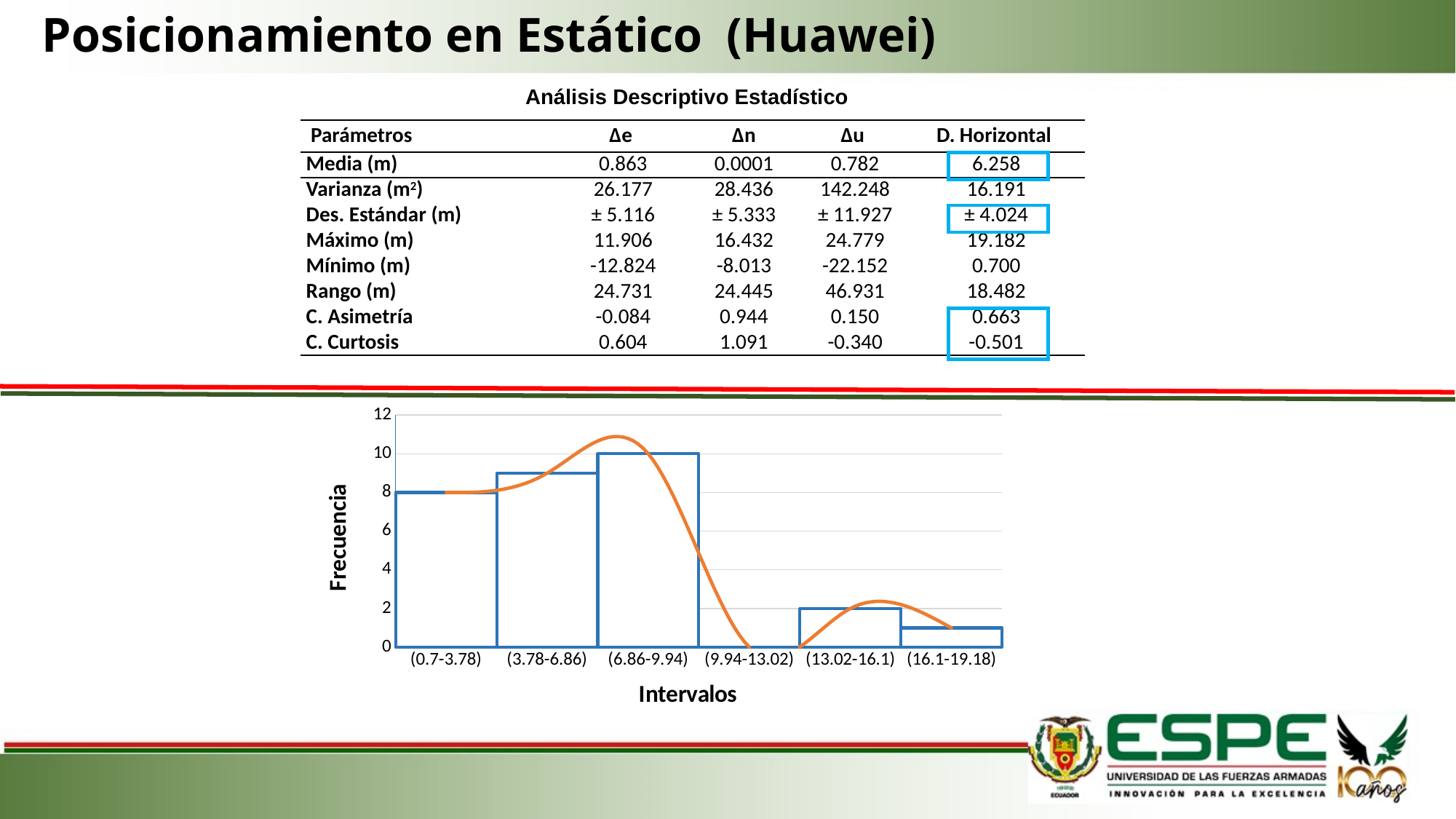
Which interval has the lowest frequency? (9.94-13.02) What is the frequency for the interval (13.02-16.1)? 2 What is the difference in frequency between the intervals (6.86-9.94) and (0.7-3.78)? 2 Is the frequency for the interval (3.78-6.86) greater or less than 8? greater How many intervals are shown on the x axis of the chart? 6 What is the frequency for the interval (9.94-13.02)? 0 What is the frequency for the interval (0.7-3.78)? 8 What is the frequency for the interval (6.86-9.94)? 10 What is the label of the y axis of the chart? Frecuencia What type of chart is shown at the bottom of the slide? combination bar and line chart Is the frequency for the interval (16.1-19.18) greater or less than 2? less Which interval has the highest frequency? (6.86-9.94)